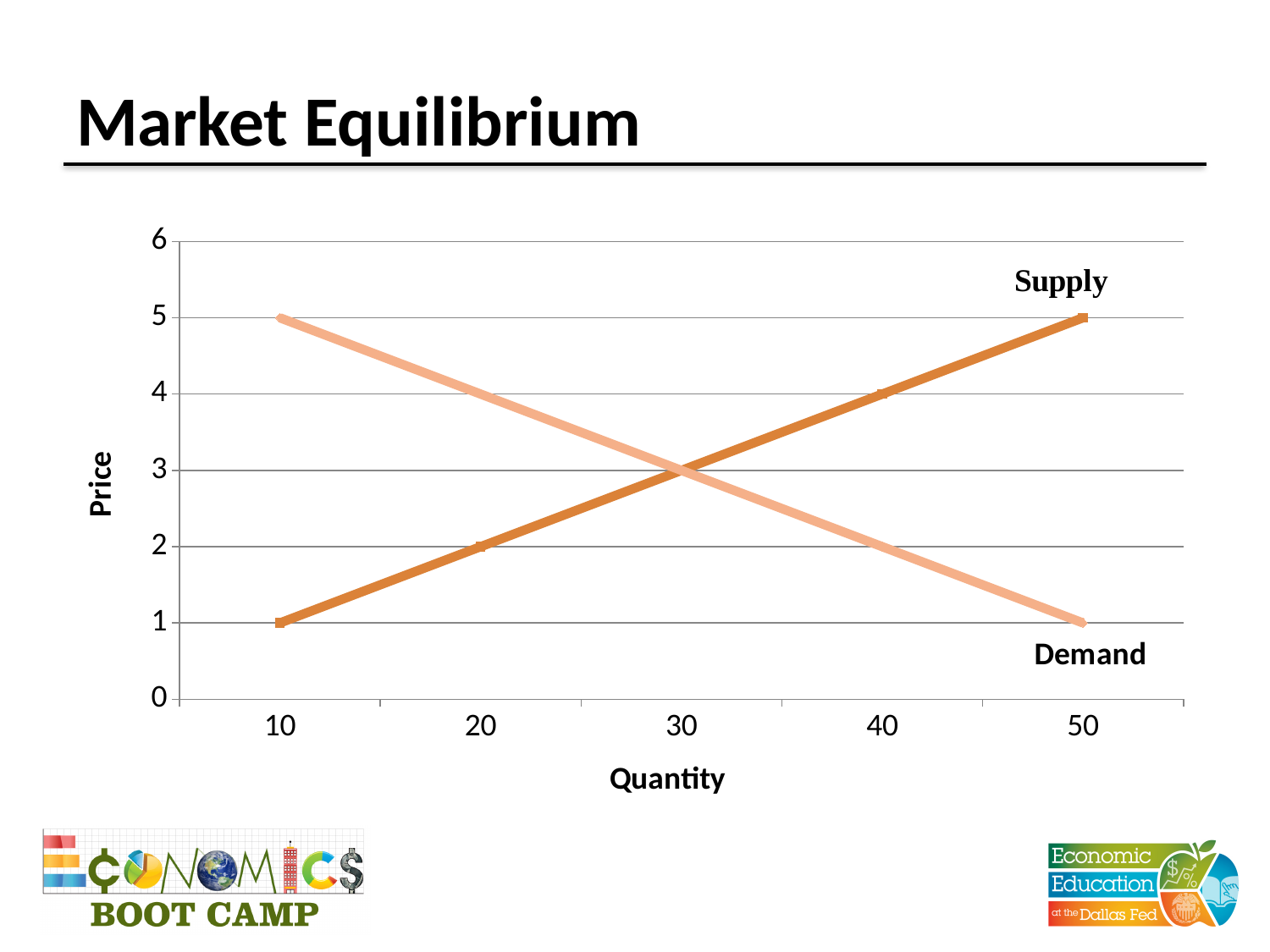
Does the Supply line rise or fall as quantity increases? rise At a quantity of 20, which line has the higher price, Supply or Demand? Demand Does the Demand line rise or fall as quantity increases? fall What kind of chart is shown on the slide? line chart At what price do the Supply and Demand lines intersect? 3 At what quantity do the Supply and Demand lines intersect? 30 What is the price on the Demand line at a quantity of 10? 5 What is the price on the Demand line at a quantity of 40? 2 What is the price on the Supply line at a quantity of 50? 5 What is the price on the Supply line at a quantity of 10? 1 How many quantity values are labelled on the x axis? 5 What is the difference between the Demand price and the Supply price at a quantity of 10? 4